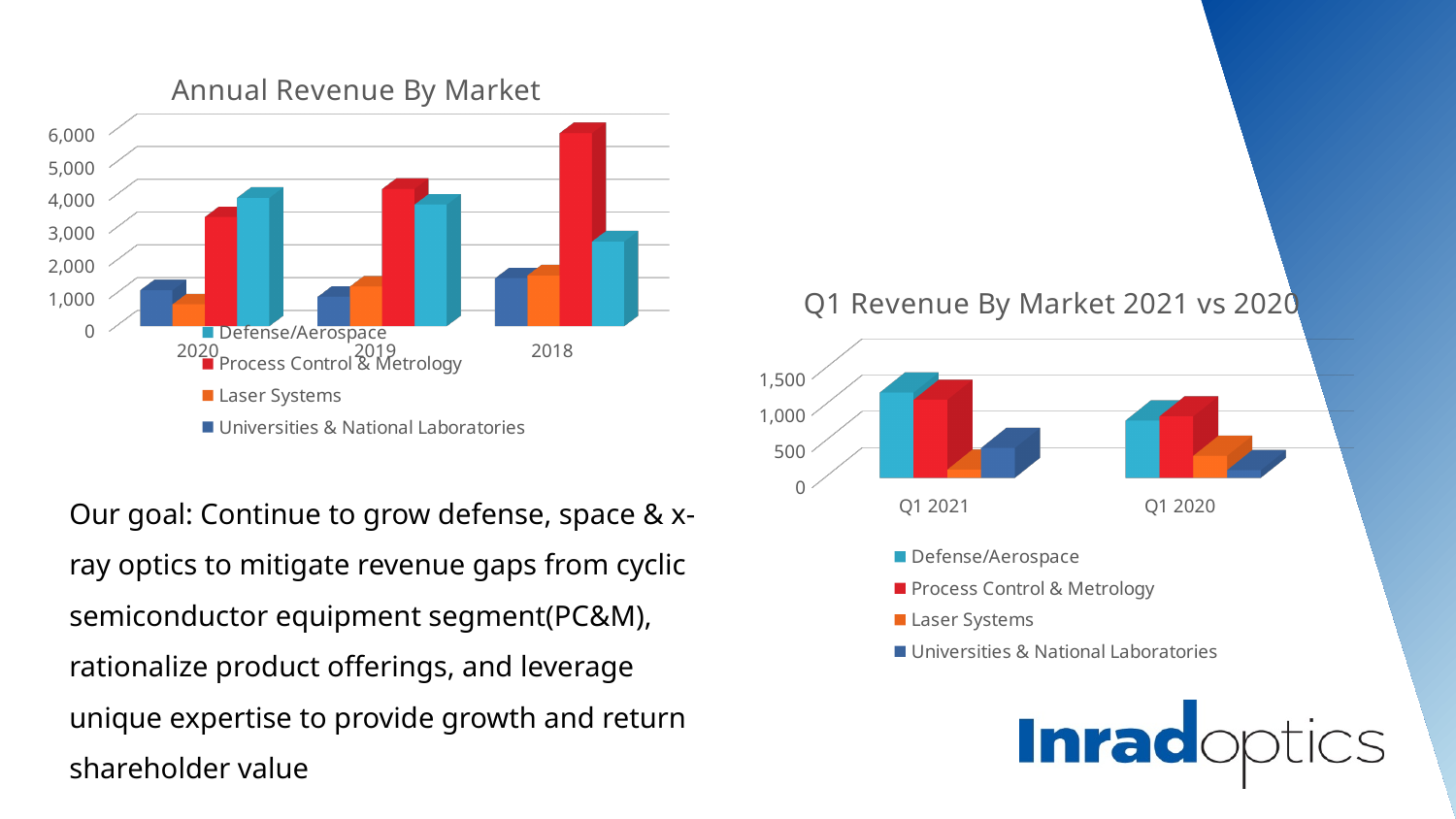
In the "Annual Revenue By Market" chart, is the Process Control & Metrology value for 2018 greater or less than 5,000? greater What kind of chart is the "Q1 Revenue By Market 2021 vs 2020" chart? bar chart In the "Annual Revenue By Market" chart, which year has the highest Process Control & Metrology bar? 2018 In the "Q1 Revenue By Market 2021 vs 2020" chart, which series has the tallest bar for Q1 2021? Defense/Aerospace In the "Annual Revenue By Market" chart, which is larger: Defense/Aerospace in 2020 or Defense/Aerospace in 2018? 2020 In the "Q1 Revenue By Market 2021 vs 2020" chart, which is larger: Laser Systems in Q1 2021 or Laser Systems in Q1 2020? Q1 2020 What kind of chart is the "Annual Revenue By Market" chart? bar chart In the "Annual Revenue By Market" chart, do the Process Control & Metrology bars rise or fall from left to right along the x axis? rise How many years are shown on the x axis of the "Annual Revenue By Market" chart? 3 How many series does the legend of the "Annual Revenue By Market" chart list? 4 In the "Annual Revenue By Market" chart, is the Laser Systems value for 2020 greater or less than 1,000? less In the "Q1 Revenue By Market 2021 vs 2020" chart, is the Defense/Aerospace value for Q1 2021 greater or less than 1,000? greater